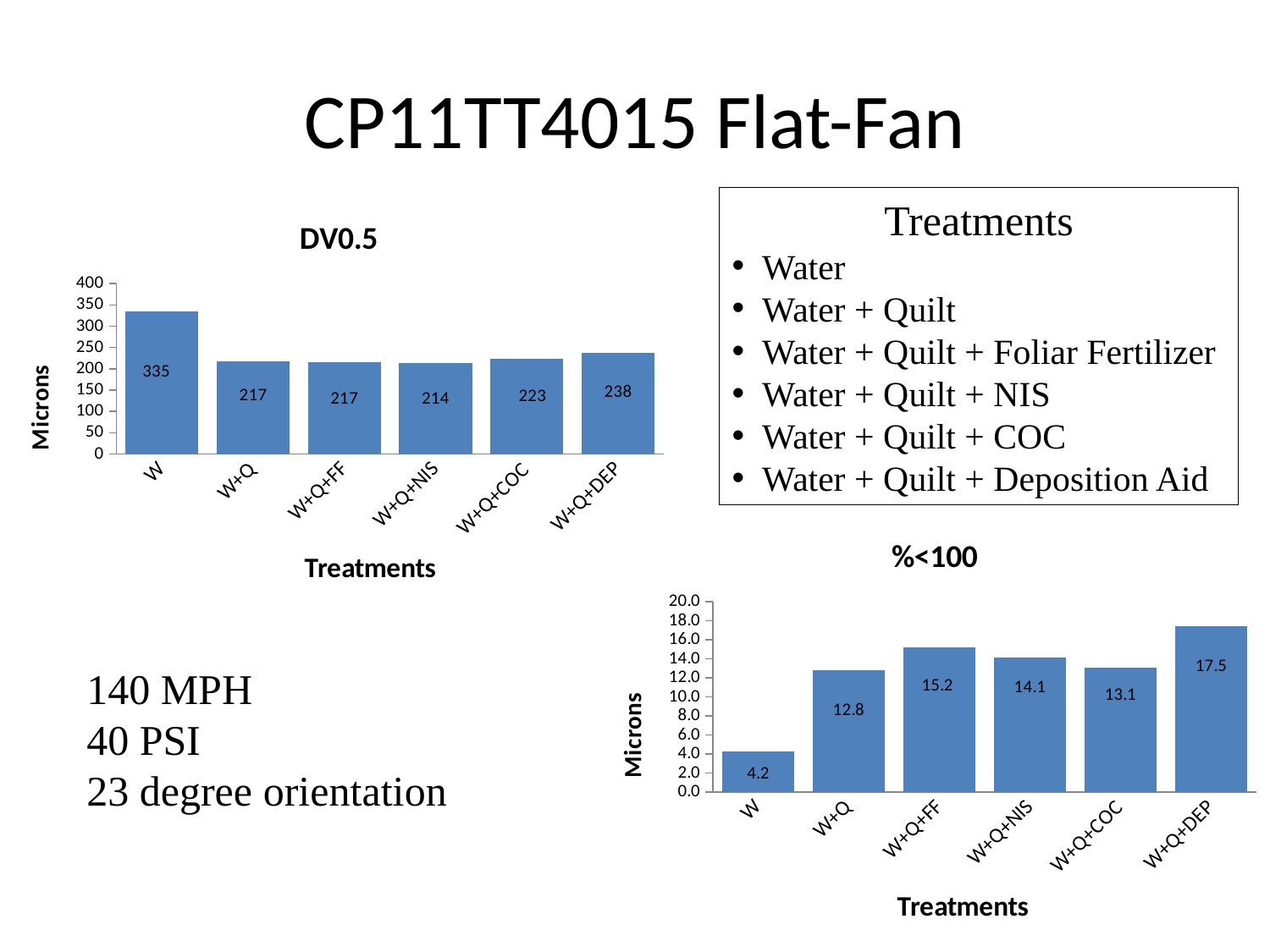
In the DV0.5 chart, how many treatments are plotted? 6 What kind of chart is the %<100 chart? bar chart In the DV0.5 chart, which treatment has the lowest value? W+Q+NIS In the %<100 chart, which is larger, the value for W+Q+NIS or W+Q+COC? W+Q+NIS In the DV0.5 chart, what is the difference between the values for W and W+Q+DEP? 97 In the %<100 chart, what is the value for W+Q+FF? 15.2 In the DV0.5 chart, is the value for W+Q+COC greater or less than 250? less In the %<100 chart, which treatment has the lowest value? W In the %<100 chart, which treatment has the highest value? W+Q+DEP What is the y-axis label of the DV0.5 chart? Microns In the %<100 chart, what is the difference between the values for W+Q+DEP and W? 13.3 In the DV0.5 chart, what is the value for W? 335